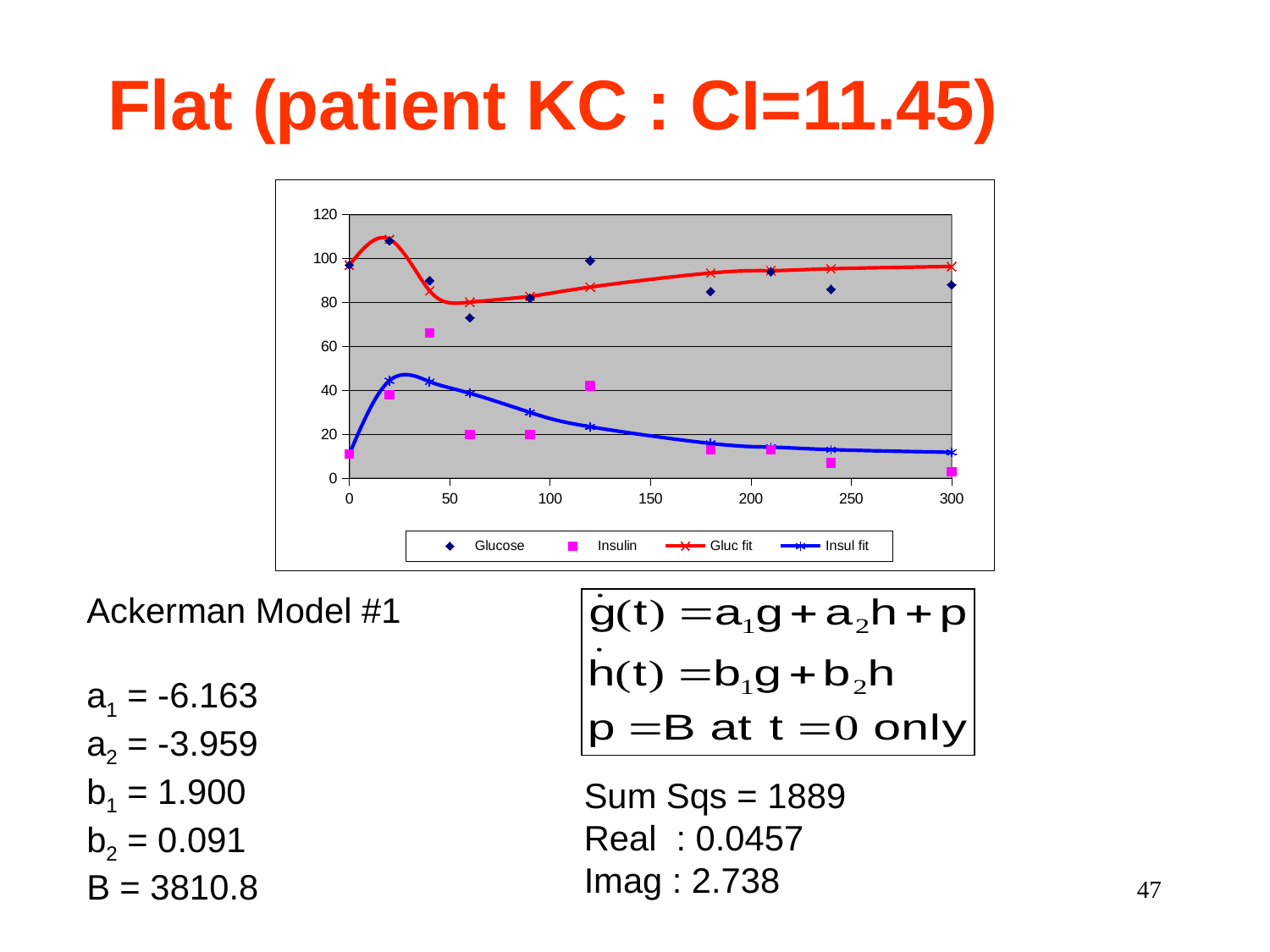
At which time value does the Insulin series reach its lowest point? 300 Is the Glucose value at time 0 greater or less than 80? greater What colour is the Insul fit line in the chart? Blue At which time value does the Glucose series reach its highest point? 20 Is the Insulin value at time 300 greater or less than 20? less How many series does the chart legend list? 4 Is the Insulin value at time 40 greater or less than 60? greater Which series is drawn as a red line in the chart? Gluc fit Does the Insul fit line rise or fall between time 50 and time 300? fall At time 0, which is larger: the Glucose value or the Insulin value? Glucose At which time value does the Insulin series reach its highest point? 40